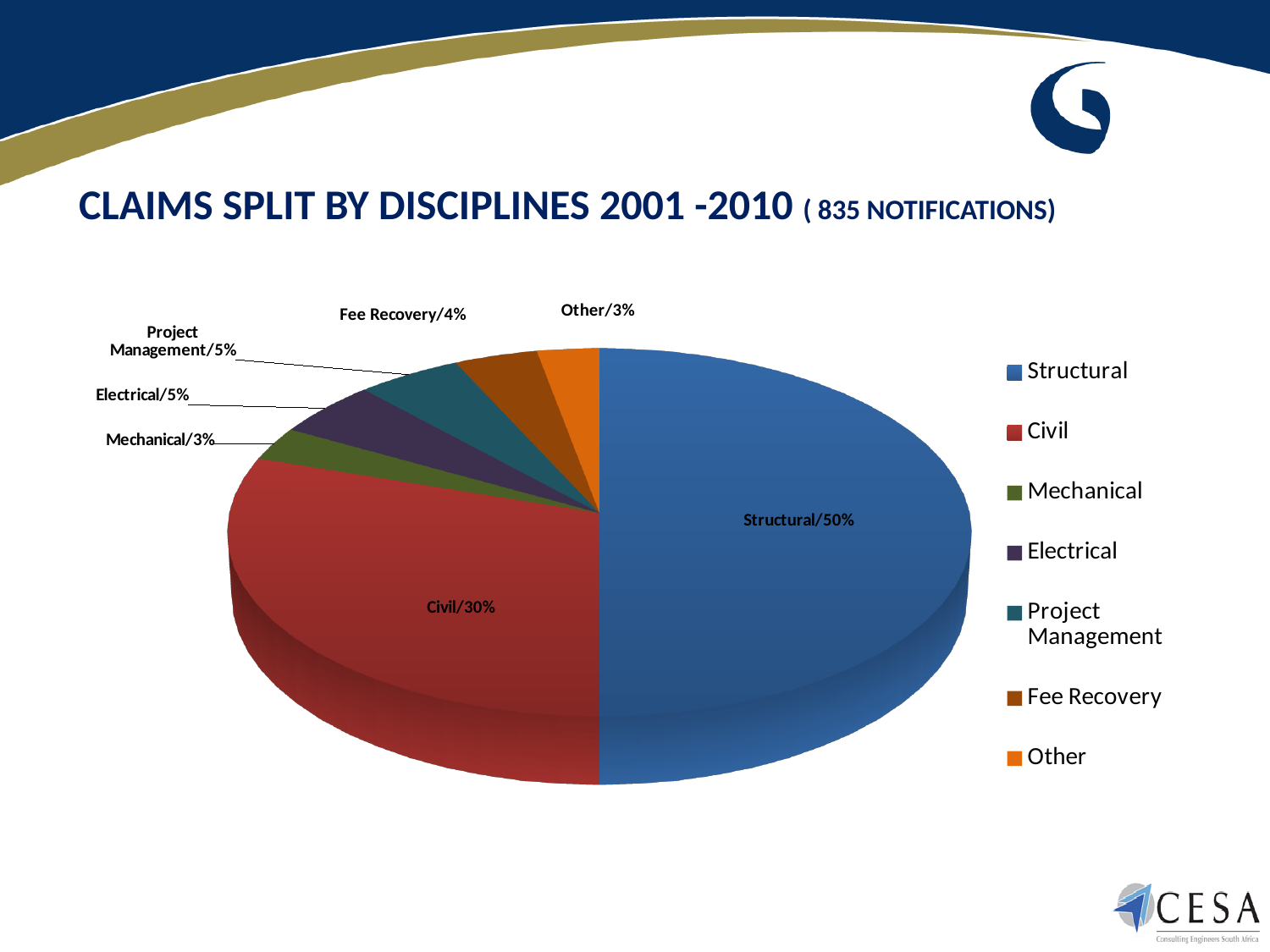
What is the title of the chart? CLAIMS SPLIT BY DISCIPLINES 2001 -2010 ( 835 NOTIFICATIONS) What share of claims is attributed to Fee Recovery? 4% What share of claims is attributed to Civil? 30% What colour is the Civil slice in the pie chart? Red What share of claims is attributed to Structural? 50% What is the combined share of Structural and Civil claims? 80% What is the difference in percentage points between the Structural and Civil shares? 20 What share of claims is attributed to Project Management? 5% How many slices does the pie chart have? 7 What kind of chart is shown on the slide? Pie chart Which discipline has the largest share of claims? Structural Which has a larger share of claims, Electrical or Mechanical? Electrical